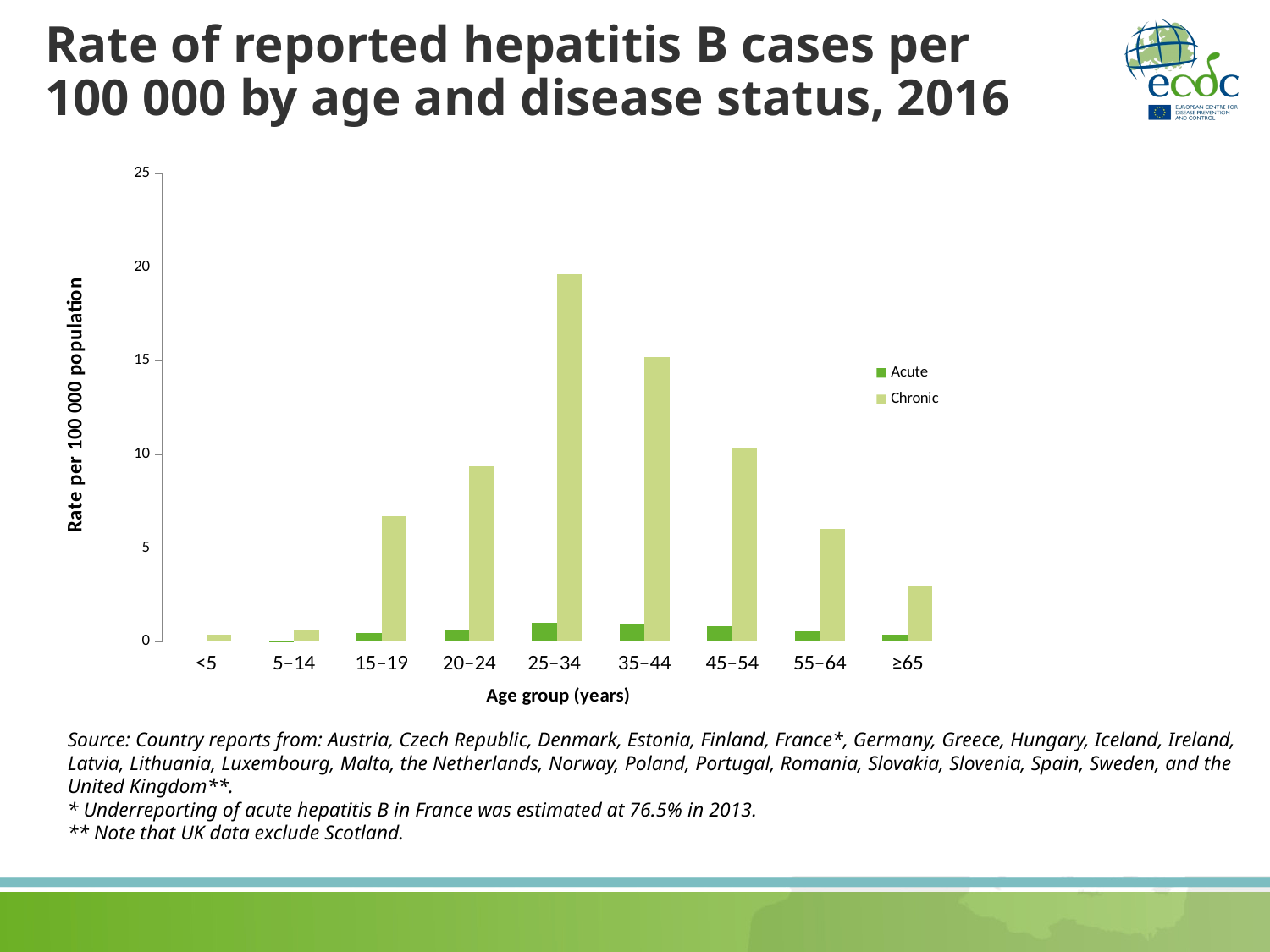
Is the Chronic rate for the 25–34 age group greater or less than 15? greater Which age group has the highest Chronic rate? 25–34 How does the Chronic rate change across the age groups from <5 to ≥65? It rises to a peak at 25–34, then falls How many age groups are shown on the x axis? 9 What is the label on the y axis? Rate per 100 000 population How many series does the legend list? 2 For the 25–34 age group, which series has the larger value, Acute or Chronic? Chronic Is the Chronic rate for the ≥65 age group greater or less than 5? less Which is larger, the Chronic rate for 35–44 or the Chronic rate for 45–54? 35–44 Is the Chronic rate for the 20–24 age group greater or less than 10? less What kind of chart is shown on the slide? Bar chart Which age group has the lowest Chronic rate? <5